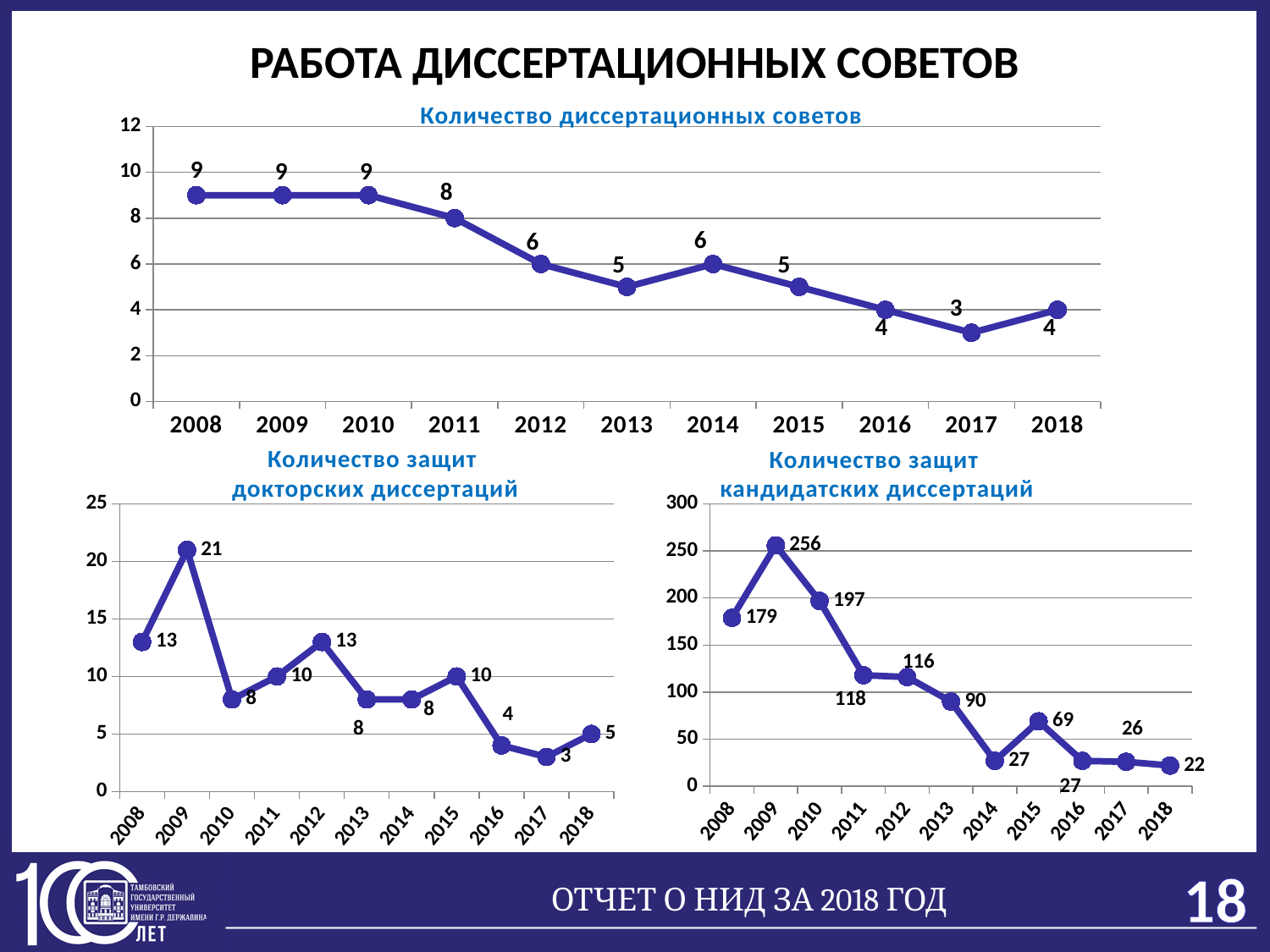
What kind of chart is 'Количество диссертационных советов'? Line chart In the chart 'Количество диссертационных советов', what is the value for 2011? 8 In the chart 'Количество защит докторских диссертаций', what is the difference between the values for 2009 and 2010? 13 In the chart 'Количество защит кандидатских диссертаций', what is the difference between the values for 2008 and 2018? 157 In the chart 'Количество защит докторских диссертаций', which is larger, the value for 2015 or the value for 2016? 2015 In the chart 'Количество защит кандидатских диссертаций', what is the value for 2013? 90 In the chart 'Количество диссертационных советов', which year has the lowest value? 2017 In the chart 'Количество диссертационных советов', how many years are plotted? 11 In the chart 'Количество защит кандидатских диссертаций', which year has the highest value? 2009 In the chart 'Количество защит докторских диссертаций', what is the value for 2009? 21 In the chart 'Количество защит кандидатских диссертаций', do the values generally rise or fall from 2009 to 2018? Fall In the chart 'Количество защит докторских диссертаций', which year has the highest value? 2009